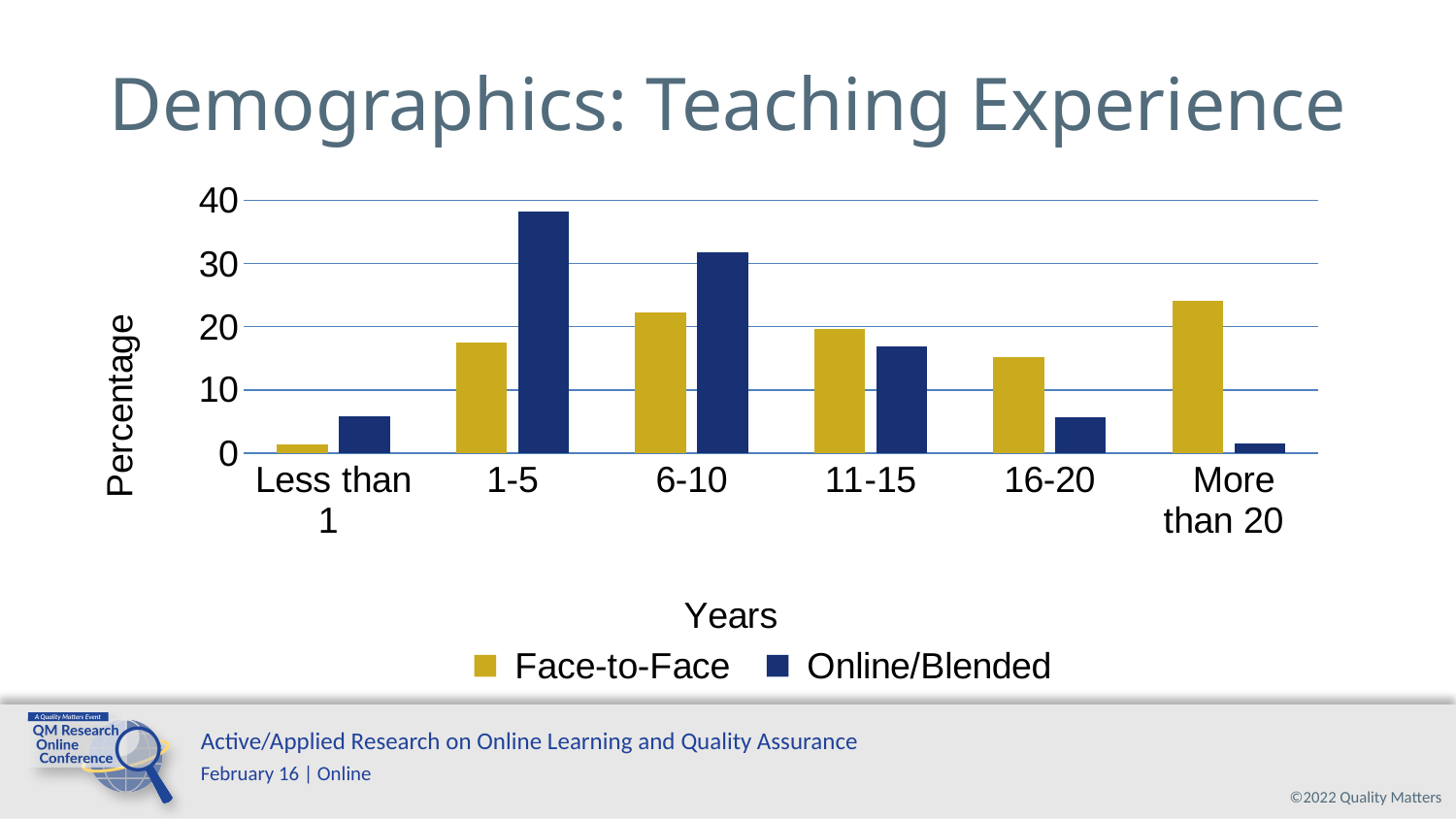
How many year categories are shown on the x axis? 6 What kind of chart is shown on the slide? bar chart Is the Face-to-Face value for 16-20 years greater or less than 20? less For the 1-5 years category, which series has the larger value, Face-to-Face or Online/Blended? Online/Blended Which year category has the lowest Face-to-Face value? Less than 1 Is the Online/Blended value for 1-5 years greater or less than 30? greater For the More than 20 years category, which series has the larger value, Face-to-Face or Online/Blended? Face-to-Face How many series does the legend list? 2 What is the label on the vertical axis of the chart? Percentage Which year category has the highest Online/Blended value? 1-5 Do the Online/Blended values rise or fall from the 1-5 category to the More than 20 category? fall Which year category has the lowest Online/Blended value? More than 20